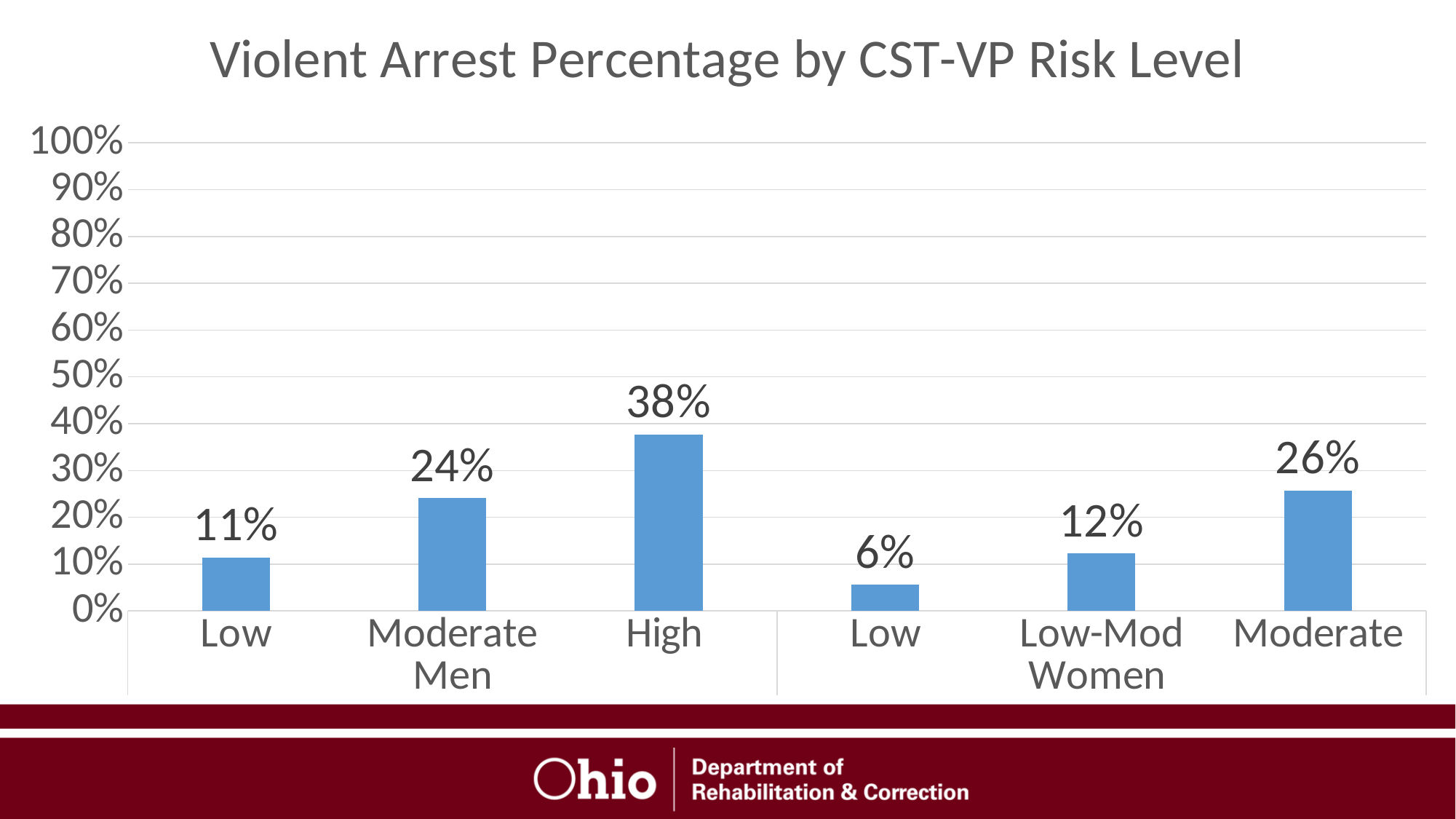
What is the violent arrest percentage for High risk Men? 38% What is the violent arrest percentage for Moderate risk Women? 26% Which category has the lowest violent arrest percentage? Low (Women) What is the difference between the violent arrest percentage for High risk Men and Moderate risk Men? 14% Which category has the highest violent arrest percentage? High (Men) What is the violent arrest percentage for Low risk Women? 6% What is the violent arrest percentage for Low-Mod risk Women? 12% What kind of chart is shown on the slide? Bar chart What is the difference between the violent arrest percentage for Low risk Men and Low risk Women? 5% How many bars are shown in the chart? 6 What is the title of the chart? Violent Arrest Percentage by CST-VP Risk Level Which is larger, the violent arrest percentage for Moderate risk Men or Moderate risk Women? Moderate risk Women